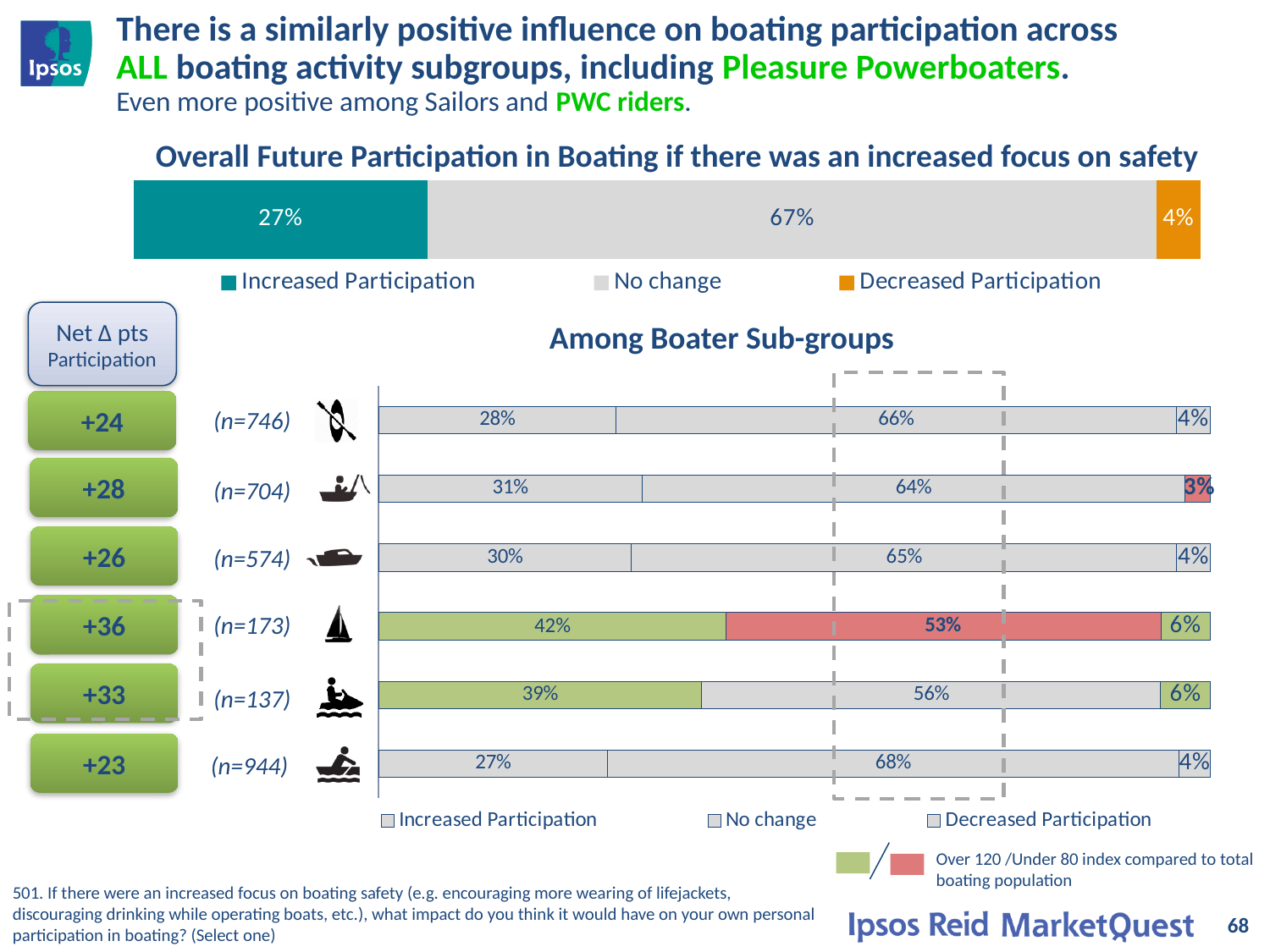
In the 'Among Boater Sub-groups' chart, how many sub-group rows are plotted? 6 In the top chart 'Overall Future Participation in Boating if there was an increased focus on safety', how many series does the legend list? 3 In the 'Among Boater Sub-groups' chart, which row has the highest Increased Participation value? (n=173) In the 'Among Boater Sub-groups' chart, what is the Increased Participation value for the row labelled (n=173)? 42% In the top chart 'Overall Future Participation in Boating if there was an increased focus on safety', what percentage is shown for No change? 67% What kind of chart is the 'Among Boater Sub-groups' chart? Stacked bar chart In the 'Among Boater Sub-groups' chart, what is the difference between the Increased Participation values for the rows (n=173) and (n=137)? 3% In the top chart 'Overall Future Participation in Boating if there was an increased focus on safety', what percentage is shown for Increased Participation? 27% In the 'Among Boater Sub-groups' chart, what is the No change value for the row labelled (n=944)? 68% In the 'Among Boater Sub-groups' chart, which row has the lowest No change value? (n=173) In the top chart 'Overall Future Participation in Boating if there was an increased focus on safety', what percentage is shown for Decreased Participation? 4% In the 'Among Boater Sub-groups' chart, what is the Decreased Participation value for the row labelled (n=704)? 3%